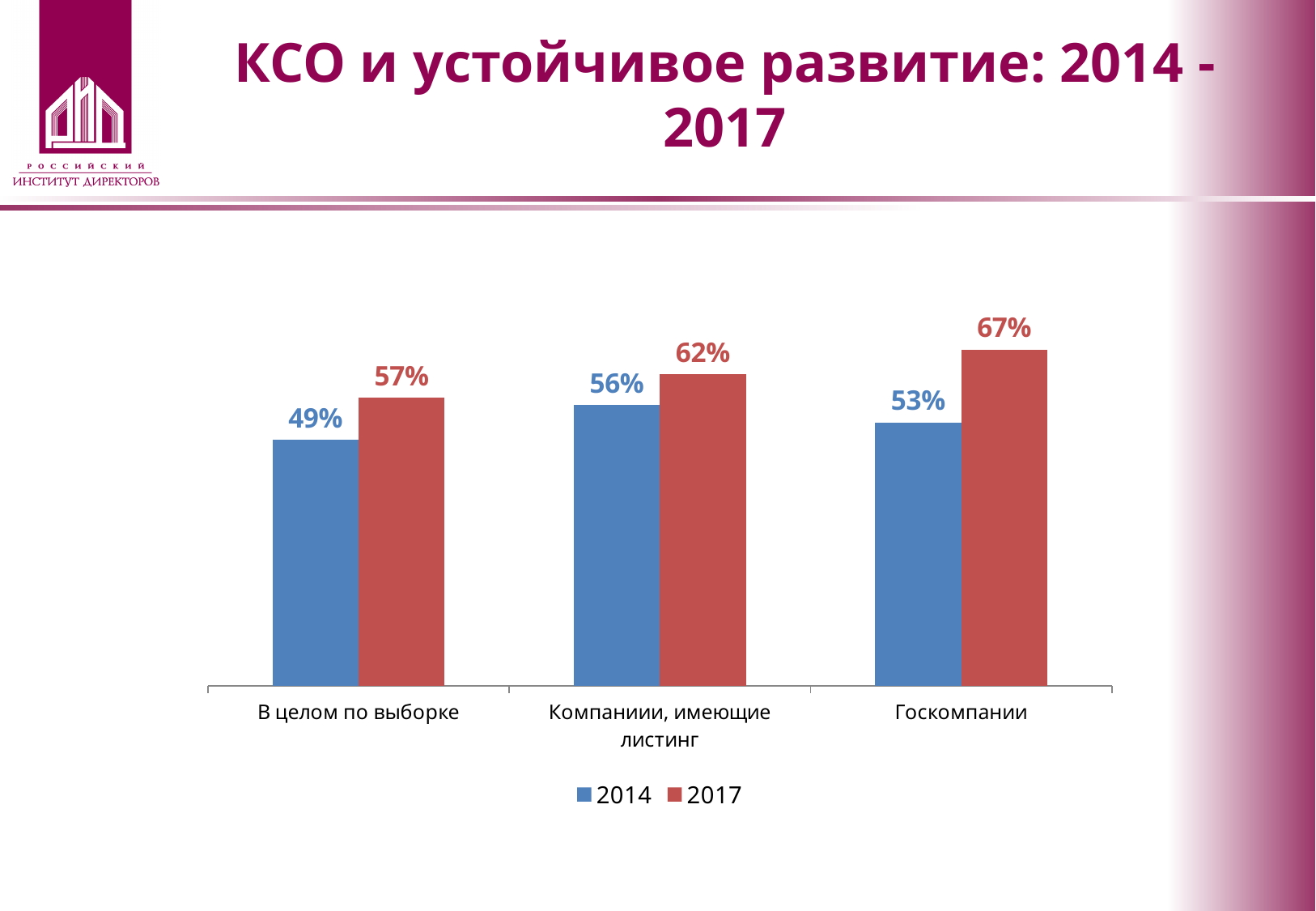
Which colour represents the 2017 series? Red What is the difference between the 2017 and 2014 values for В целом по выборке? 8% Which is larger: the 2017 value for Компаниии, имеющие листинг or the 2017 value for В целом по выборке? Компаниии, имеющие листинг What is the 2014 value for Компаниии, имеющие листинг? 56% How many series does the legend list? 2 Which category has the lowest 2014 value? В целом по выборке What kind of chart is shown on the slide? Bar chart Which category has the highest 2017 value? Госкомпании What is the 2014 value for В целом по выборке? 49% How many categories are shown on the x axis? 3 What is the 2017 value for Госкомпании? 67% What is the difference between the 2017 and 2014 values for Госкомпании? 14%